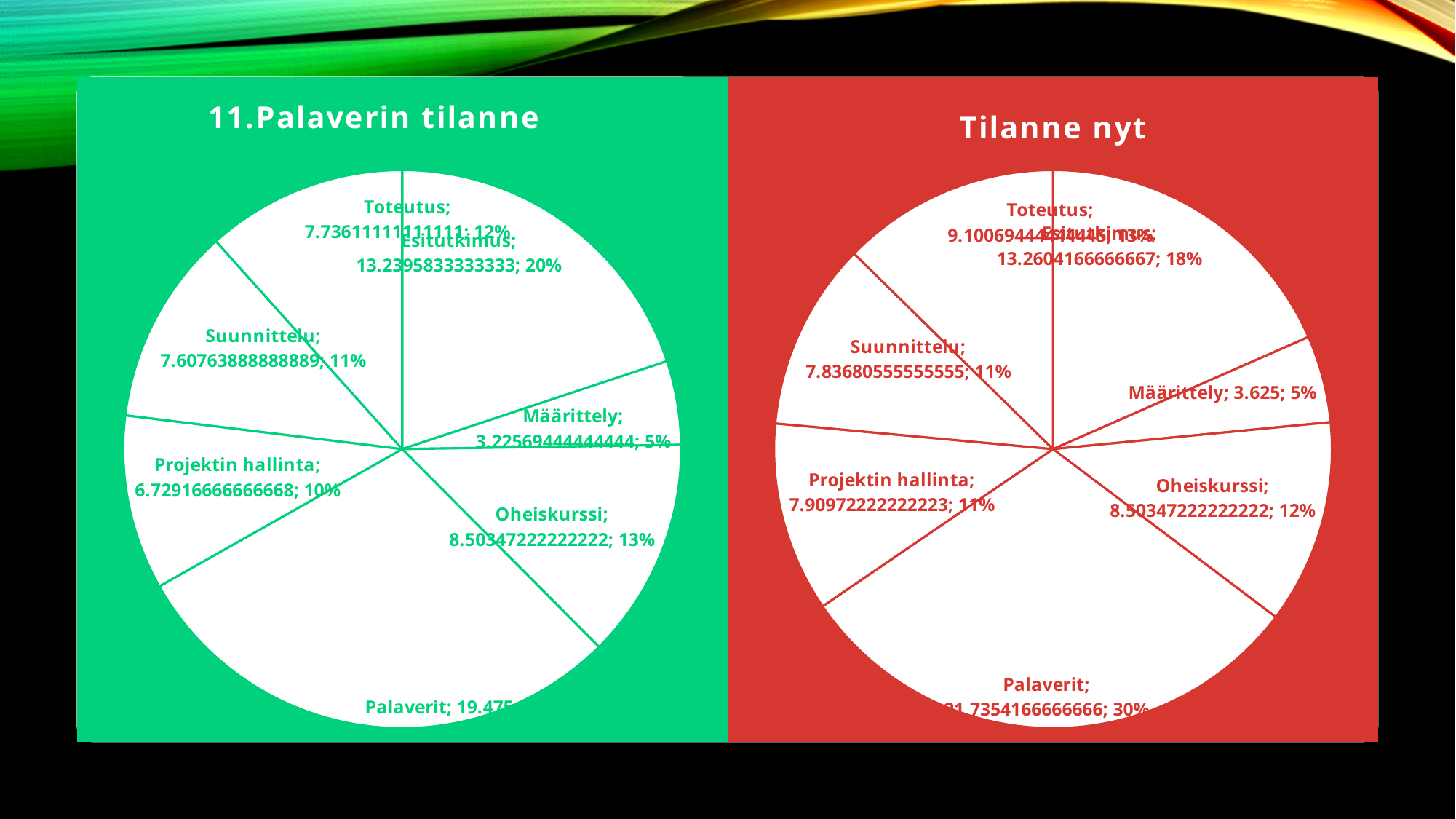
In the "Tilanne nyt" chart, what is the difference in percentage share between Esitutkimus and Oheiskurssi? 6 percentage points What is the title of the chart on the left side of the slide? 11.Palaverin tilanne In the "11.Palaverin tilanne" chart, what value is shown for Suunnittelu? 7.60763888888889 In the "11.Palaverin tilanne" chart, what share of the pie does Esitutkimus have? 20% In the "Tilanne nyt" chart, what share of the pie does Palaverit have? 30% In the "Tilanne nyt" chart, which category has the largest slice? Palaverit In the "Tilanne nyt" chart, what value is shown for Määrittely? 3.625 In the "11.Palaverin tilanne" chart, which category has the smallest slice? Määrittely What kind of chart is the "11.Palaverin tilanne" chart? Pie chart In the "11.Palaverin tilanne" chart, which is larger, Oheiskurssi or Suunnittelu? Oheiskurssi In the "Tilanne nyt" chart, which category has the smallest slice? Määrittely How many categories does the "Tilanne nyt" chart show? 7